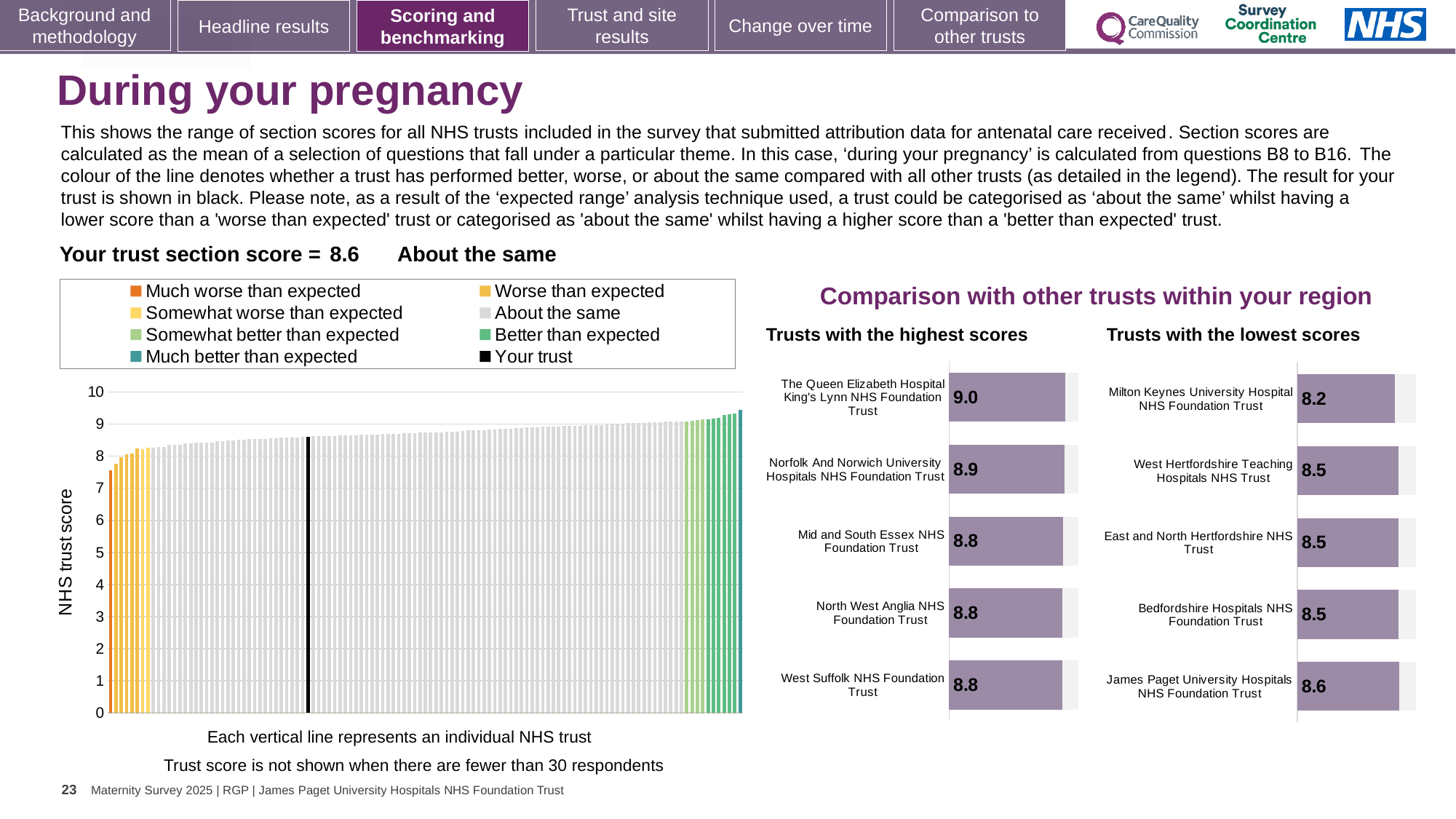
In the 'Trusts with the highest scores' chart, what is the score for The Queen Elizabeth Hospital King's Lynn NHS Foundation Trust? 9.0 In the 'Trusts with the highest scores' chart, which trust has the highest score? The Queen Elizabeth Hospital King's Lynn NHS Foundation Trust In the 'Trusts with the highest scores' chart, how many trusts are shown? 5 In the 'Trusts with the lowest scores' chart, which has the larger score: James Paget University Hospitals NHS Foundation Trust or Milton Keynes University Hospital NHS Foundation Trust? James Paget University Hospitals NHS Foundation Trust In the 'Trusts with the lowest scores' chart, what is the score for Milton Keynes University Hospital NHS Foundation Trust? 8.2 In the 'Trusts with the lowest scores' chart, what is the difference between the scores of James Paget University Hospitals NHS Foundation Trust and Milton Keynes University Hospital NHS Foundation Trust? 0.4 How many entries does the legend of the large chart on the left list? 8 What kind of chart is the large chart on the left with the y-axis labelled 'NHS trust score'? Bar chart In the 'Trusts with the lowest scores' chart, which trust has the lowest score? Milton Keynes University Hospital NHS Foundation Trust In the large chart on the left, is the value of the lowest (orange) bar greater or less than 8? less In the 'Trusts with the highest scores' chart, what is the difference between the scores of The Queen Elizabeth Hospital King's Lynn NHS Foundation Trust and Norfolk And Norwich University Hospitals NHS Foundation Trust? 0.1 In the 'Trusts with the lowest scores' chart, what is the score for West Hertfordshire Teaching Hospitals NHS Trust? 8.5